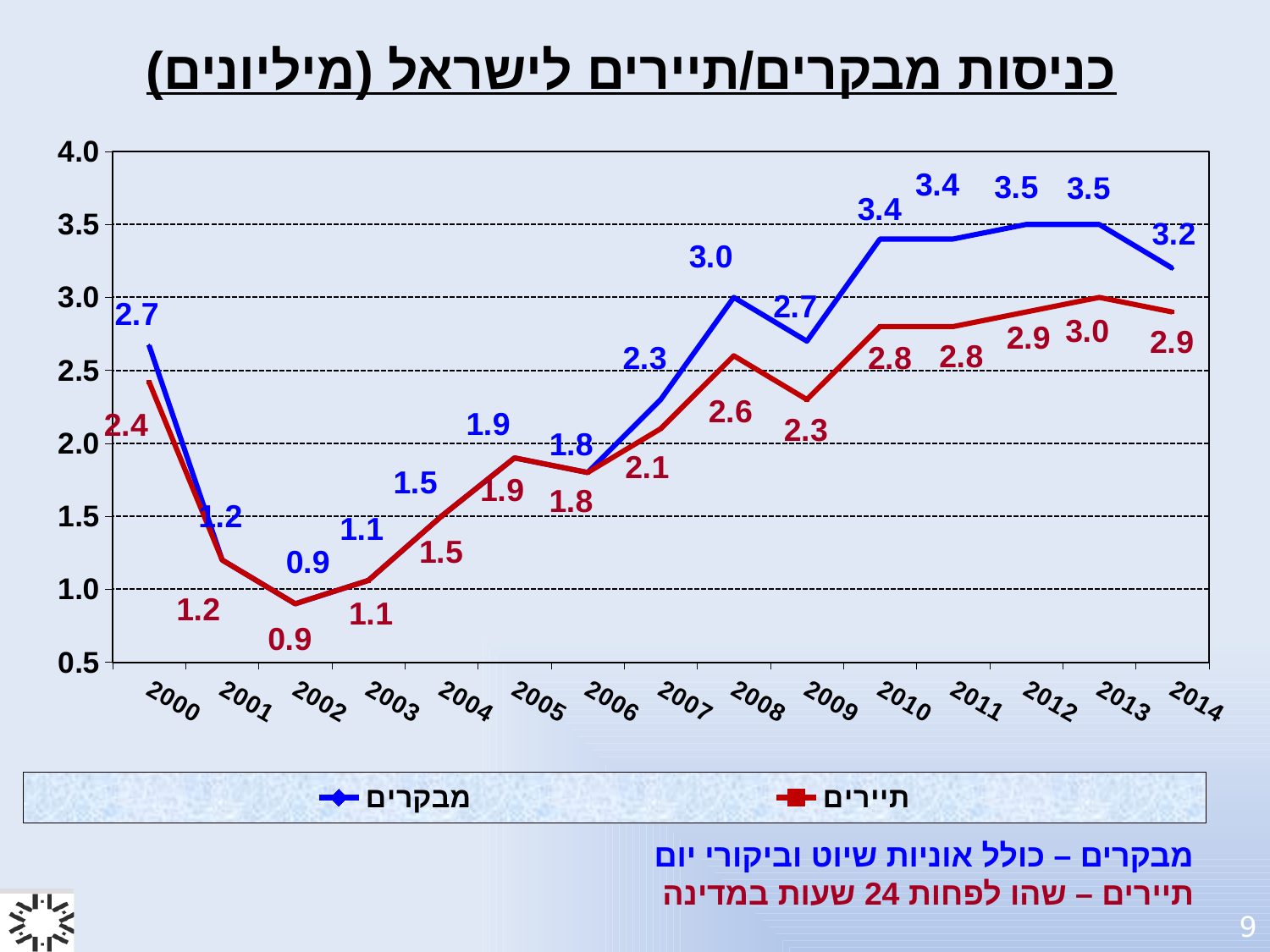
Do the values for תיירים rise or fall from 2009 to 2013? rise Which colour is used for the מבקרים series? blue In which year is the value for תיירים highest? 2013 What is the difference between מבקרים and תיירים in 2010? 0.6 What is the value for תיירים in 2014? 2.9 What type of chart is shown on the slide? line chart How many series does the legend list? 2 What is the value for תיירים in 2000? 2.4 How many years are shown on the x axis? 15 Which series has the larger value in 2009, מבקרים or תיירים? מבקרים What is the value for מבקרים in 2008? 3.0 In which year is the value for מבקרים lowest? 2002